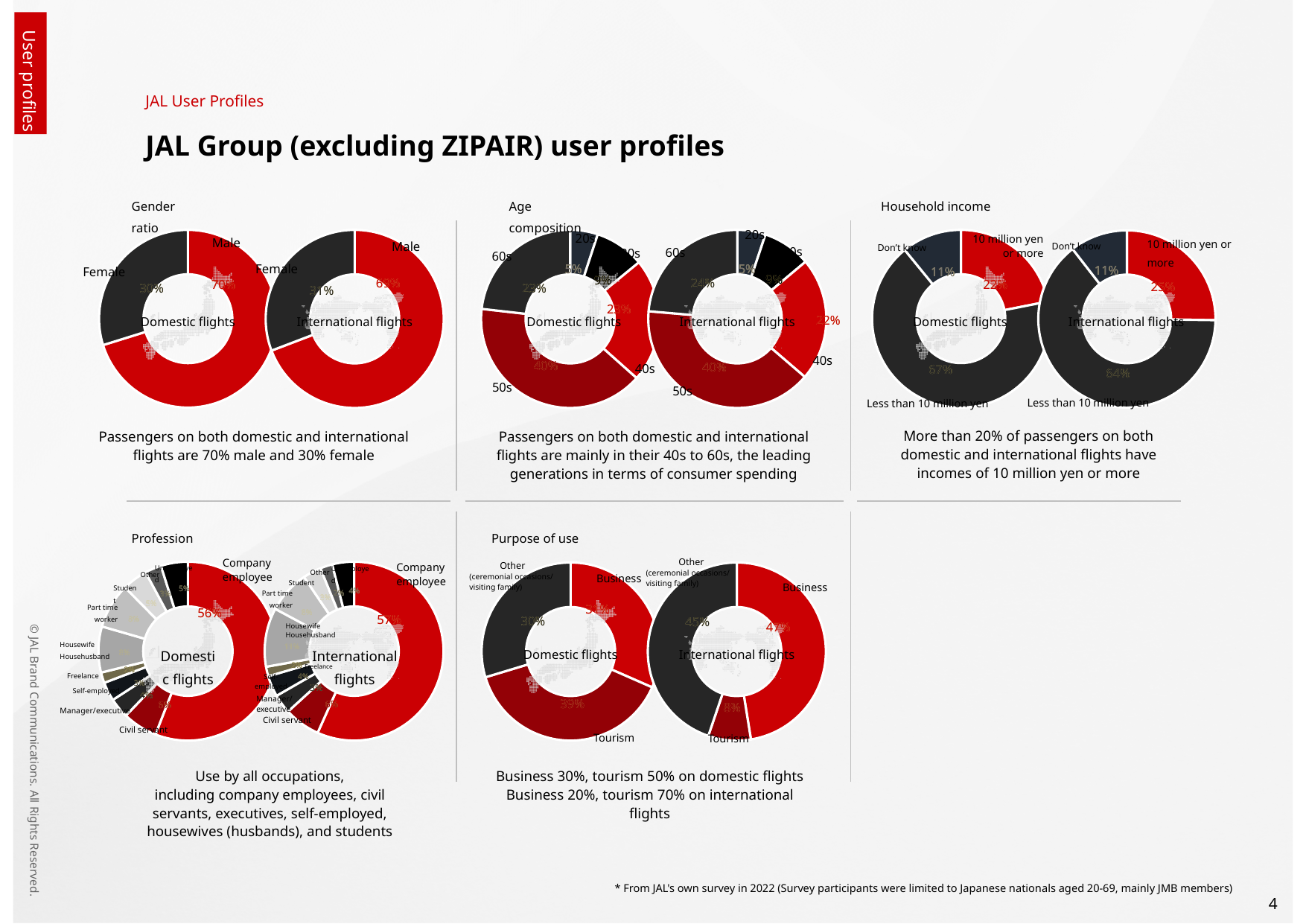
In the Household income chart for International flights, what share of passengers have incomes of less than 10 million yen? 64% In the Gender ratio chart for Domestic flights, what is the difference between the male and female shares? 40% In the Gender ratio chart for Domestic flights, what percentage of passengers are male? 70% In the Household income chart for Domestic flights, which category is the largest? Less than 10 million yen In the Age composition chart for Domestic flights, what share of passengers are in their 50s? 40% How many categories does the Household income chart for Domestic flights show? 3 In the Household income chart for Domestic flights, what share of passengers answered 'Don't know'? 11% In the Household income chart for Domestic flights, what share of passengers have incomes of less than 10 million yen? 67% In the Gender ratio chart for Domestic flights, what percentage of passengers are female? 30% What kind of chart is used for the Gender ratio on this slide? Donut (pie) chart In the Profession chart for Domestic flights, what share of passengers are company employees? 56% In the Gender ratio chart for International flights, what percentage of passengers are male? 69%